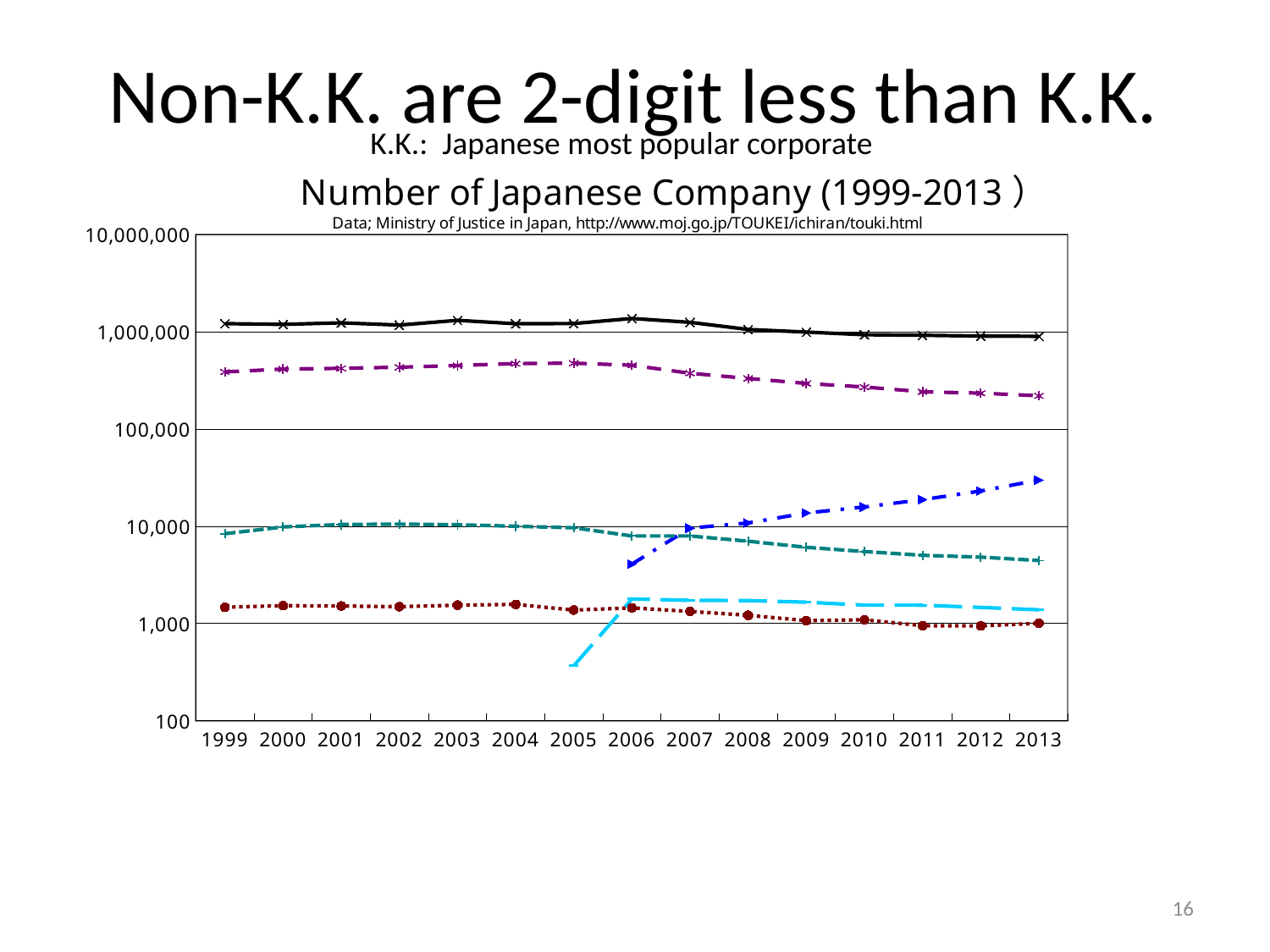
Is the value of the purple dashed line in 2013 greater or less than 100,000? greater Does the dark blue dash-dot line rise or fall from 2006 to 2013? rise Which line is the highest across all years on the chart? the black solid line What is the title of the chart? Number of Japanese Company (1999-2013 ) Is the value of the dark blue dash-dot line in 2013 greater or less than 10,000? greater How many years are shown along the x axis of the chart? 15 How many lines are plotted on the chart? 6 What is the highest value labelled on the y axis? 10,000,000 Is the value of the black solid line in 2013 greater or less than 100,000? greater What kind of chart is shown on the slide? line chart